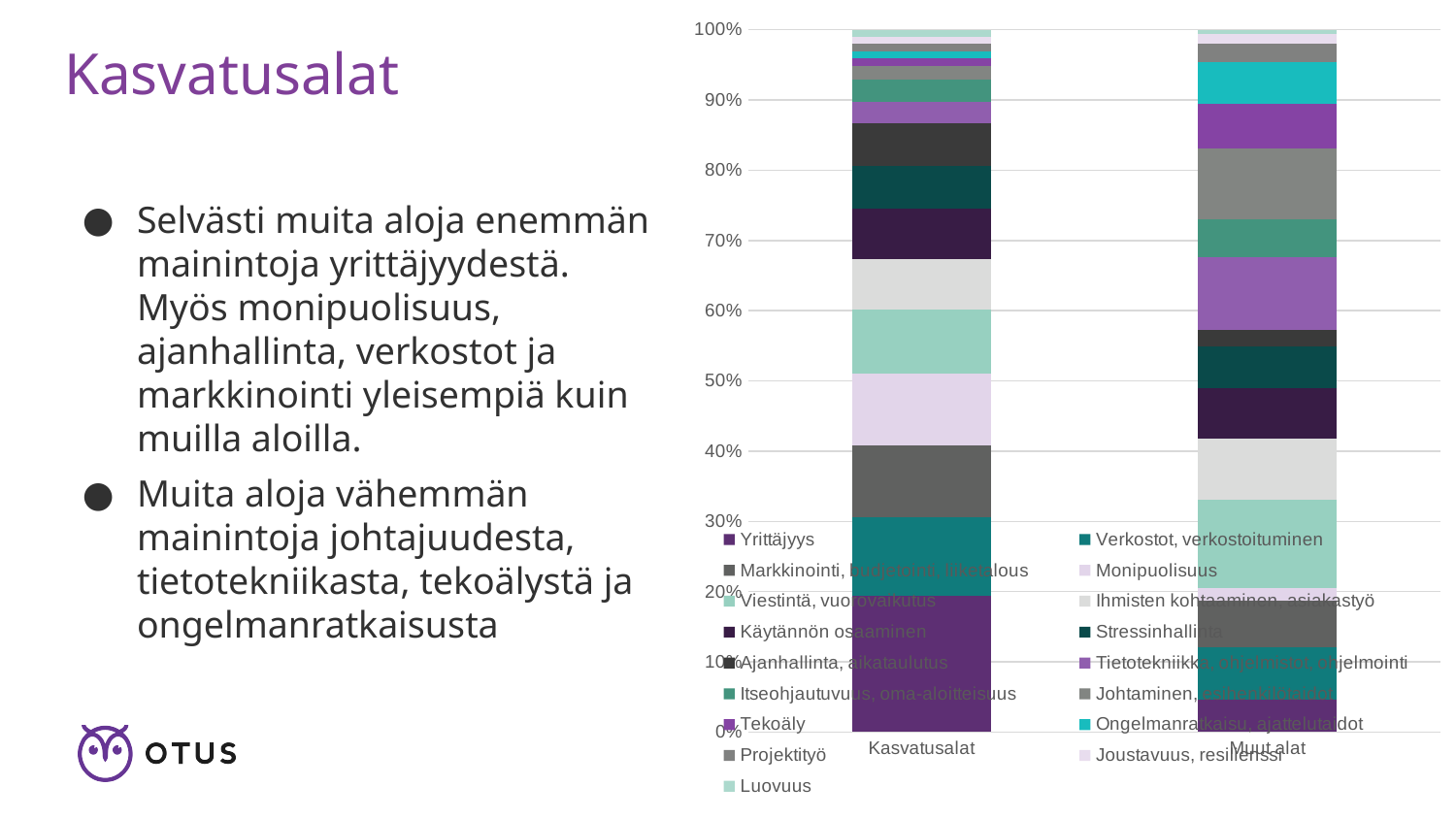
What is the total height of each stacked bar in the chart? 100% What kind of chart is shown on the slide? Stacked bar chart Which bar has the larger Johtaminen segment, Kasvatusalat or Muut alat? Muut alat Which bar has the larger Ajanhallinta, aikataulutus segment, Kasvatusalat or Muut alat? Kasvatusalat What are the two categories on the x axis of the chart? Kasvatusalat and Muut alat Is the Yrittäjyys share of the Muut alat bar greater or less than 10%? less Which bar has the larger Tekoäly segment, Kasvatusalat or Muut alat? Muut alat How many categories are shown on the x axis of the chart? 2 How many series does the chart's legend list? 17 Is the Yrittäjyys share of the Kasvatusalat bar greater or less than 10%? greater What is the title of the slide containing the chart? Kasvatusalat